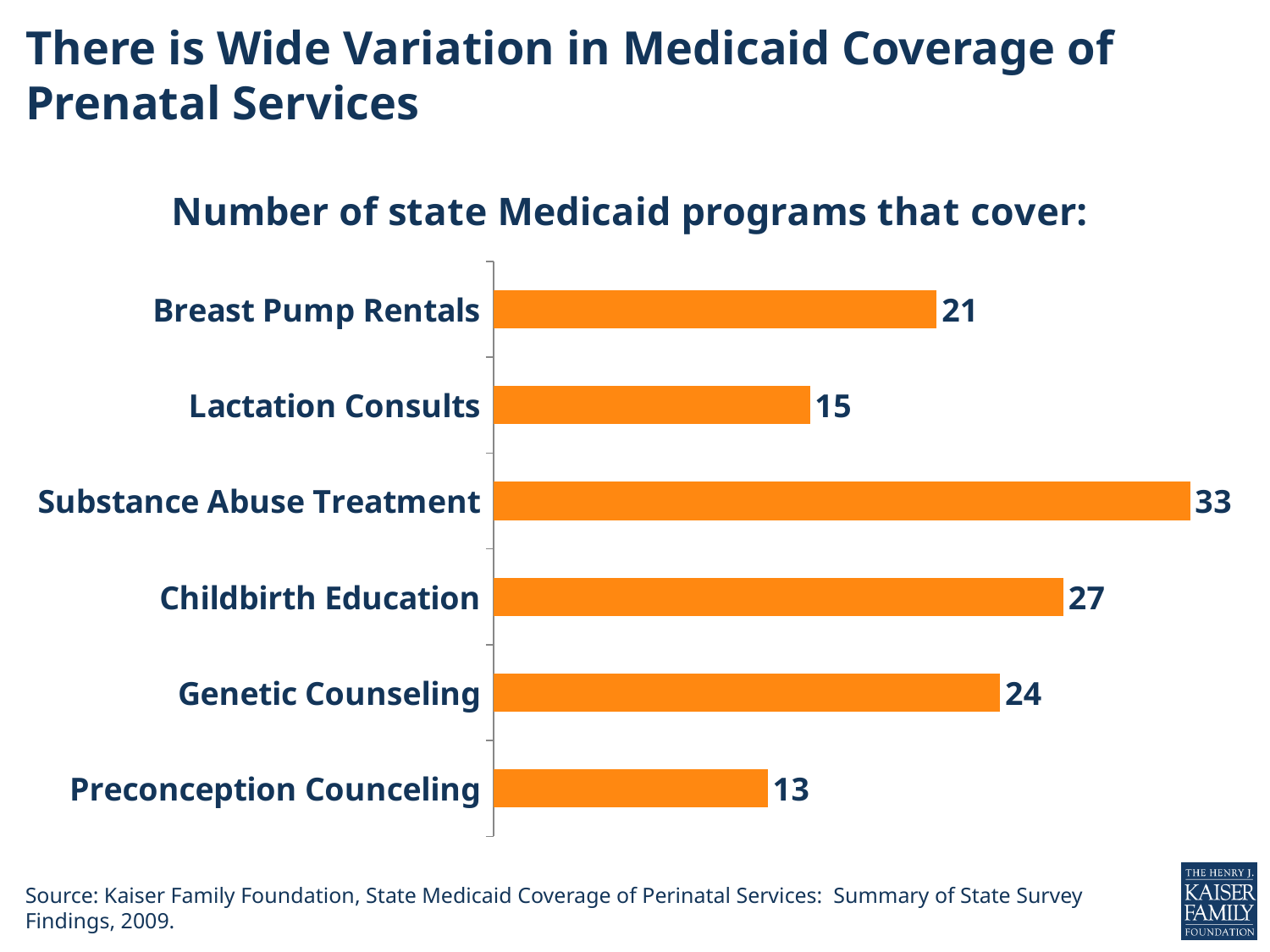
How many state Medicaid programs cover Lactation Consults? 15 What kind of chart is shown on the slide? Bar chart Which is covered by more state Medicaid programs, Breast Pump Rentals or Childbirth Education? Childbirth Education What is the title of the chart? Number of state Medicaid programs that cover: How many services are shown in the chart? 6 Which service is covered by the most state Medicaid programs? Substance Abuse Treatment How many state Medicaid programs cover Genetic Counseling? 24 How many more state Medicaid programs cover Childbirth Education than Breast Pump Rentals? 6 Which is covered by more state Medicaid programs, Genetic Counseling or Lactation Consults? Genetic Counseling What is the difference between the number of programs covering Substance Abuse Treatment and Preconception Counceling? 20 Which service is covered by the fewest state Medicaid programs? Preconception Counceling How many state Medicaid programs cover Substance Abuse Treatment? 33